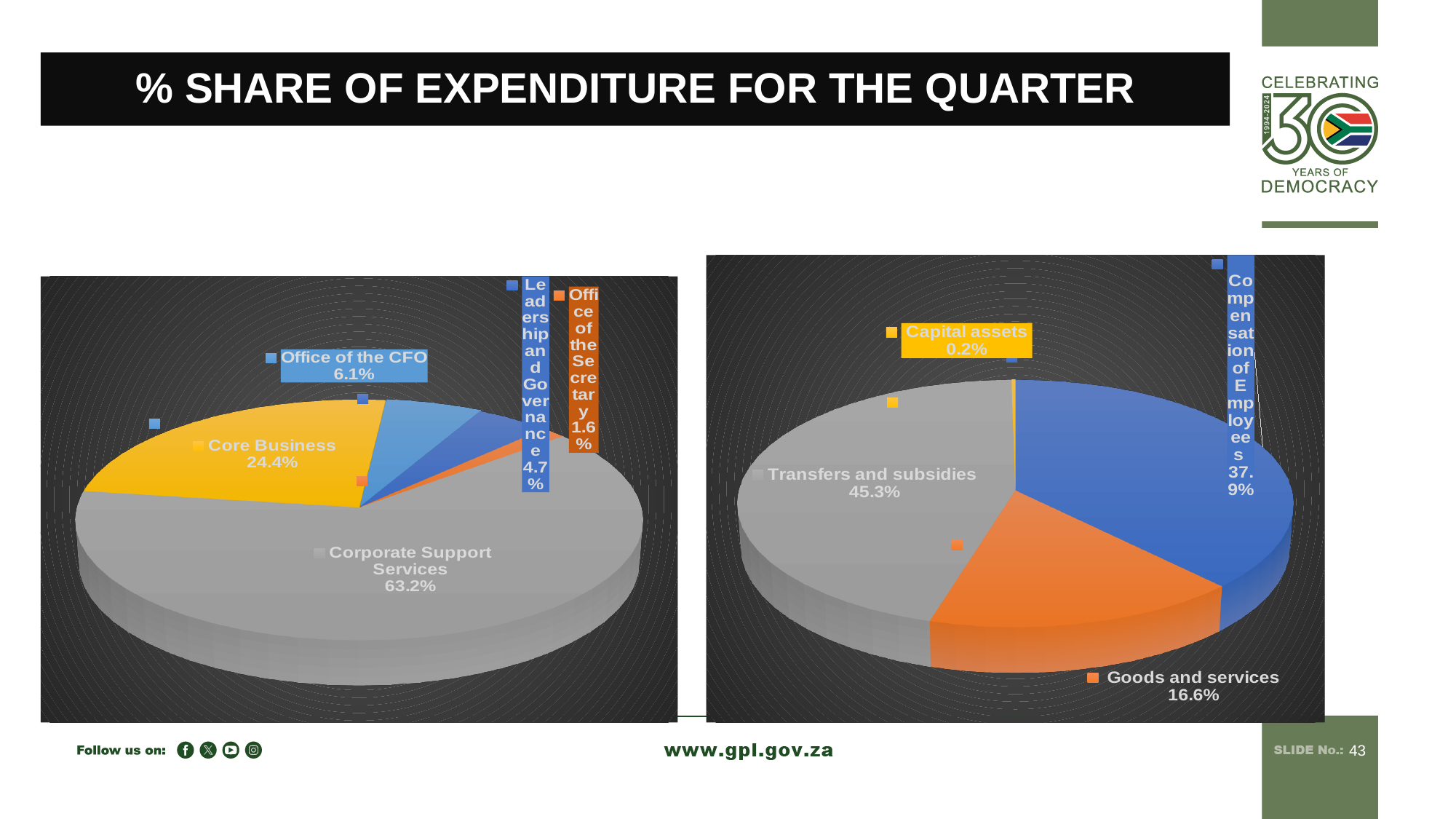
What type of chart is used on this slide? Pie chart In the right pie chart, what is the share for Transfers and subsidies? 45.3% In the left pie chart, what is the difference between the shares for Core Business and Office of the CFO? 18.3% In the left pie chart, which category has the smallest share? Office of the Secretary In the left pie chart, what is the share for Office of the CFO? 6.1% In the right pie chart, how many categories are shown? 4 In the left pie chart, how many slices are there? 5 In the right pie chart, what is the share for Goods and services? 16.6% In the right pie chart, which is larger: Compensation of Employees or Goods and services? Compensation of Employees In the left pie chart, what is the share for Core Business? 24.4% In the right pie chart, which category has the largest share? Transfers and subsidies In the left pie chart, what is the share for Corporate Support Services? 63.2%